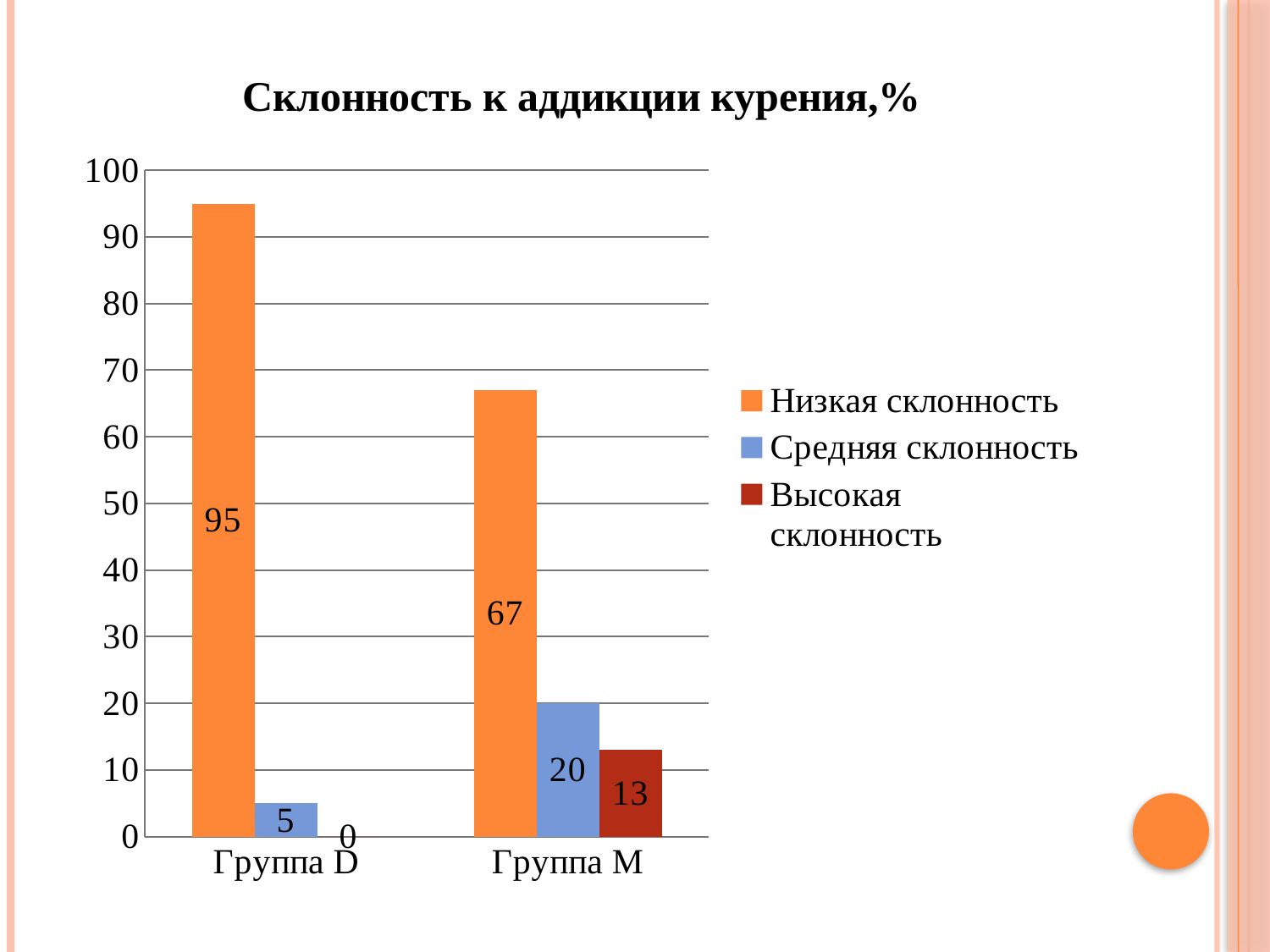
Which group has the higher value for Низкая склонность? Группа D What is the value of Низкая склонность for Группа D? 95 What is the value of Высокая склонность for Группа M? 13 What is the difference between Средняя склонность and Высокая склонность for Группа M? 7 How many series does the legend list? 3 What is the title of the chart? Склонность к аддикции курения,% What kind of chart is shown on the slide? Bar chart What is the value of Высокая склонность for Группа D? 0 How many groups are shown on the x axis? 2 What is the difference between the Низкая склонность values for Группа D and Группа M? 28 What is the value of Средняя склонность for Группа M? 20 Which series has the lowest value for Группа M? Высокая склонность